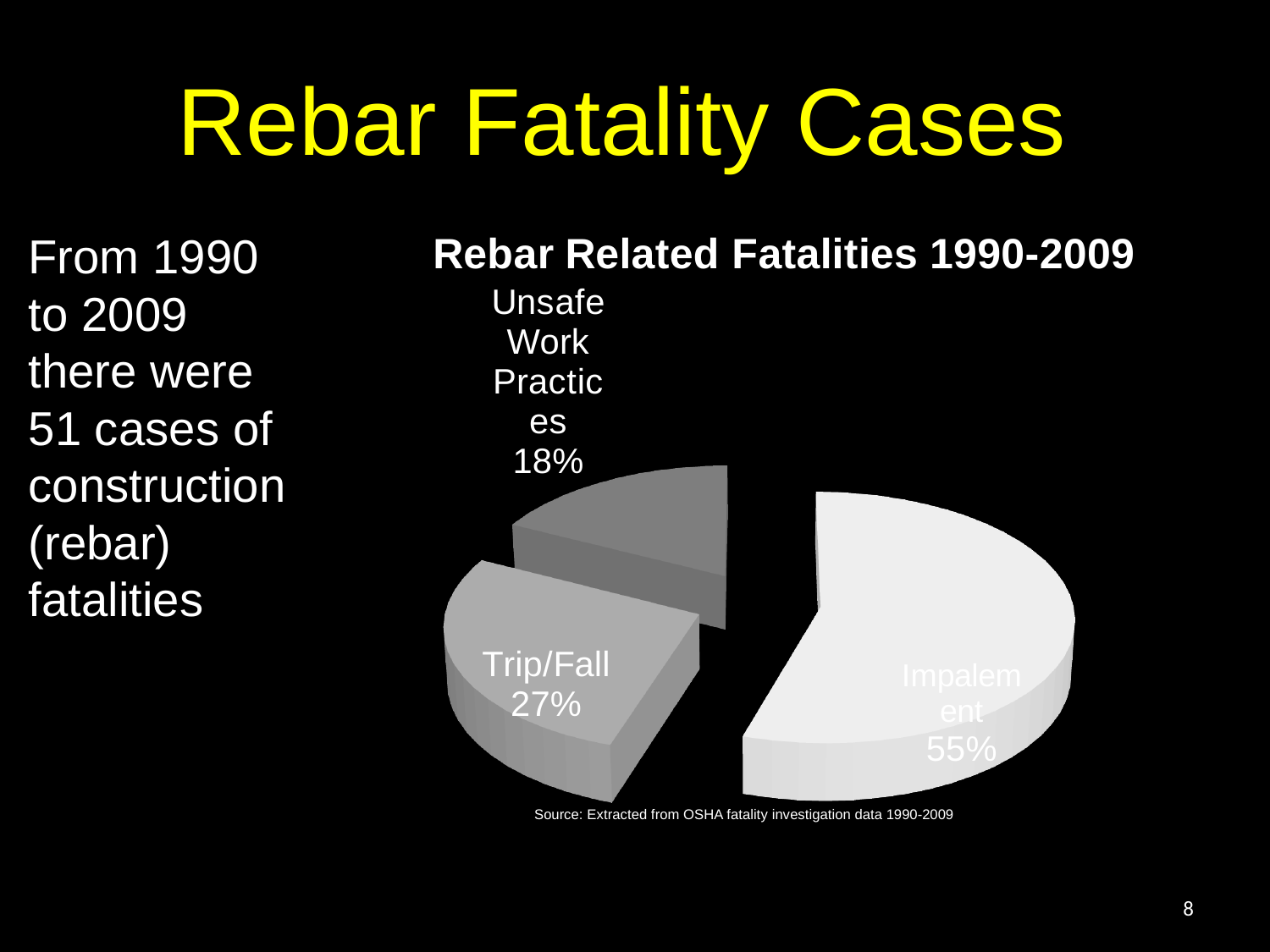
What is the title of the chart? Rebar Related Fatalities 1990-2009 What is the difference in percentage points between the Trip/Fall and Unsafe Work Practices shares? 9 Which is larger, the share for Trip/Fall or the share for Unsafe Work Practices? Trip/Fall What share of rebar related fatalities is attributed to Unsafe Work Practices? 18% How many categories are shown in the pie chart? 3 What source is cited below the chart? Extracted from OSHA fatality investigation data 1990-2009 Which category accounts for the largest share of rebar related fatalities? Impalement What is the difference in percentage points between the Impalement and Trip/Fall shares? 28 What kind of chart is shown on the slide? Pie chart What share of rebar related fatalities is attributed to Impalement? 55% Which category accounts for the smallest share of rebar related fatalities? Unsafe Work Practices What share of rebar related fatalities is attributed to Trip/Fall? 27%